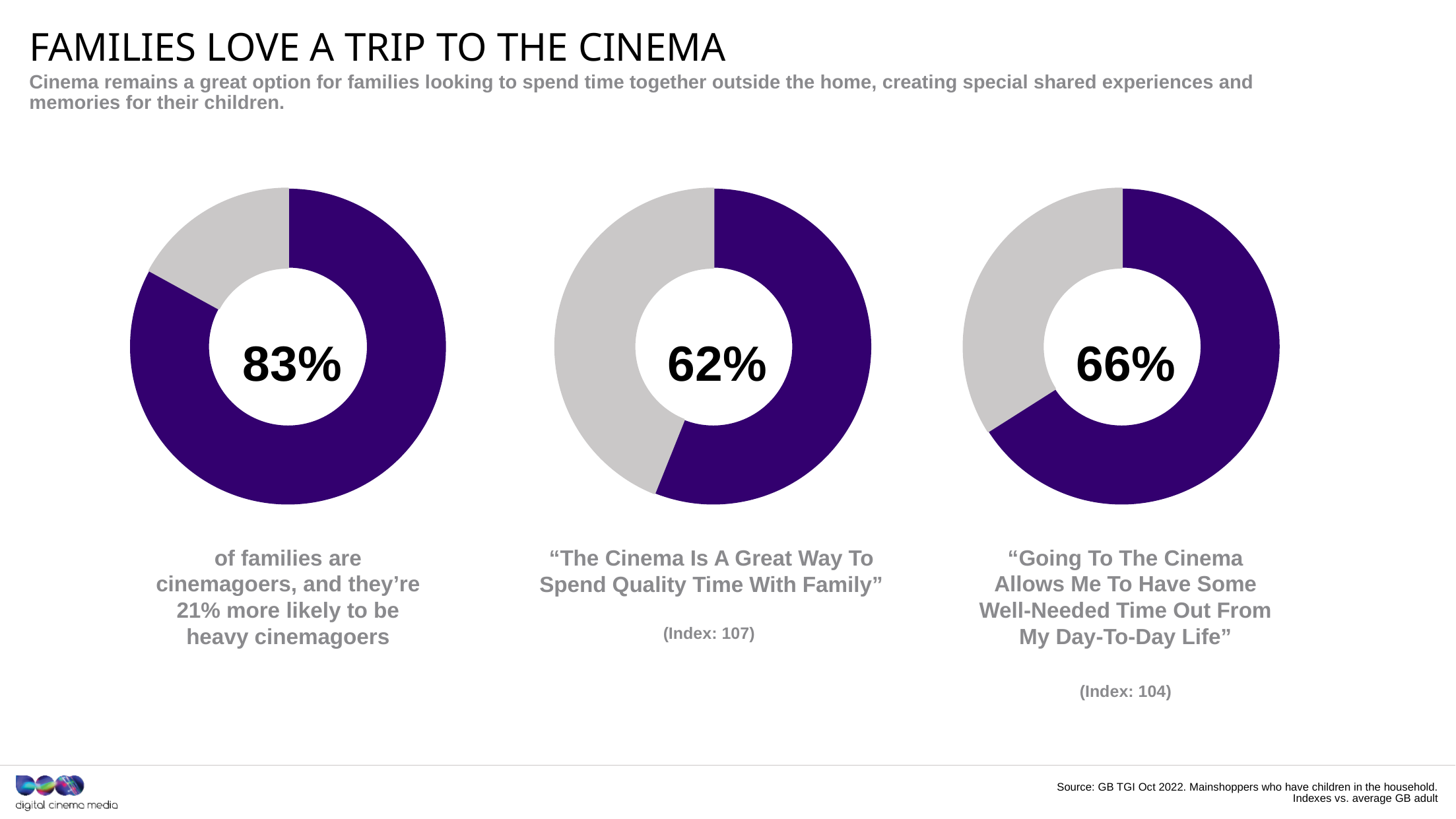
What percentage is shown in the middle doughnut chart for "The Cinema Is A Great Way To Spend Quality Time With Family"? 62% Which of the three doughnut charts shows the lowest percentage? The middle chart (62%) Is the percentage in the right chart larger or smaller than the percentage in the middle chart? Larger What colour is the filled (highlighted) portion of each doughnut chart? Dark purple How many doughnut charts are on the slide? 3 What kind of chart is used to display the percentages on this slide? Doughnut chart What index is shown beneath the middle doughnut chart? Index: 107 What is the difference between the percentage in the left chart and the percentage in the middle chart? 21 percentage points What percentage is shown in the right doughnut chart for "Going To The Cinema Allows Me To Have Some Well-Needed Time Out From My Day-To-Day Life"? 66% What is the difference between the percentage in the right chart and the percentage in the middle chart? 4 percentage points Which of the three doughnut charts shows the highest percentage? The left chart (83%) What percentage is shown in the left doughnut chart (families who are cinemagoers)? 83%